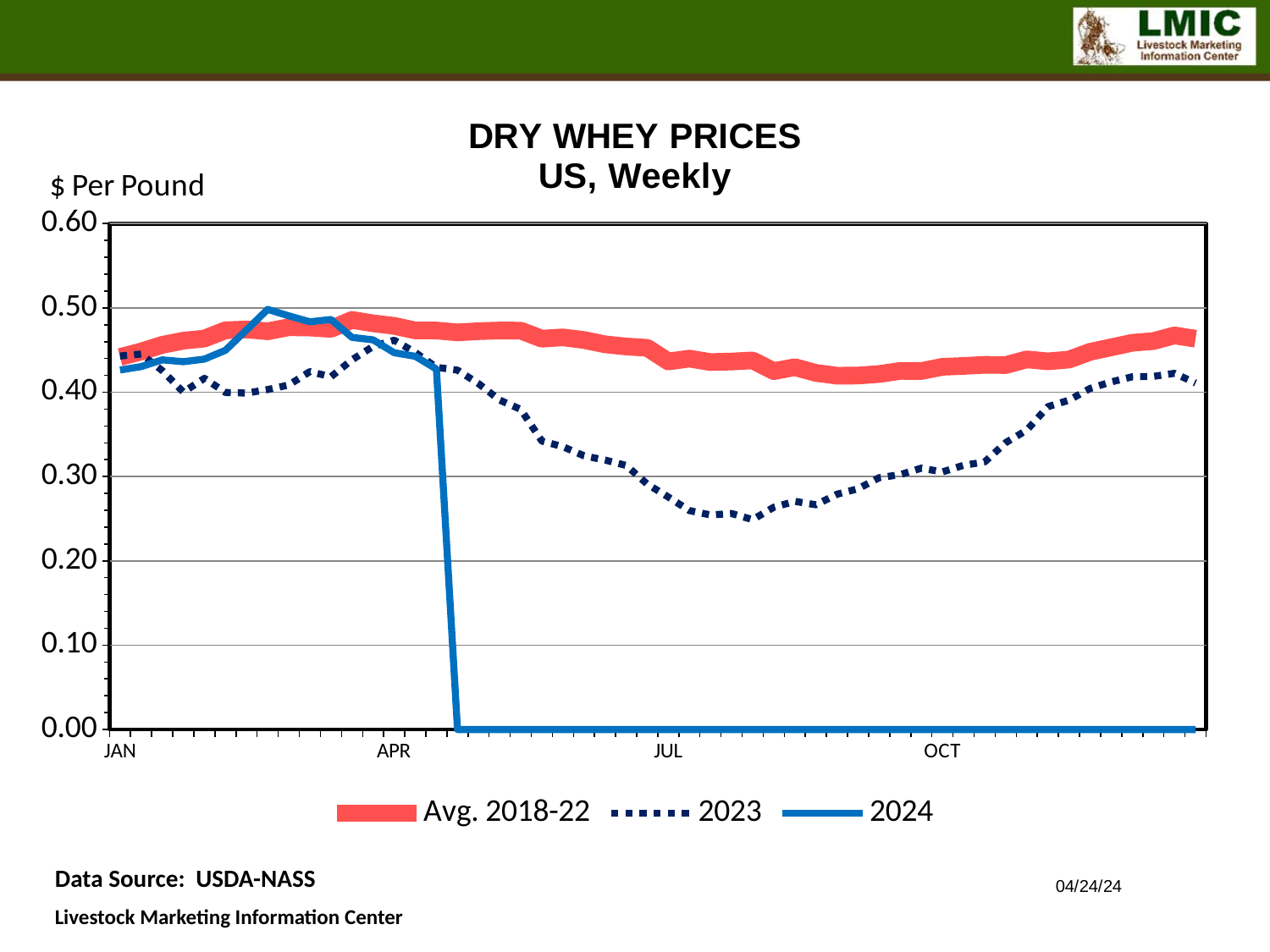
Is the peak value of the 2024 series greater or less than 0.40? greater Does the 2023 series rise or fall between August and December? Rise What is the title of the chart? DRY WHEY PRICES US, Weekly Is the value of the Avg. 2018-22 series in January greater or less than 0.40? greater Is the value of the 2023 series in August greater or less than 0.30? less How many series does the legend list? 3 How many month labels are shown on the x-axis? 4 Does the 2023 series rise or fall between April and July? Fall What kind of chart is shown on the slide? Line chart What unit is shown on the y-axis label? $ Per Pound In July, which series is higher: Avg. 2018-22 or 2023? Avg. 2018-22